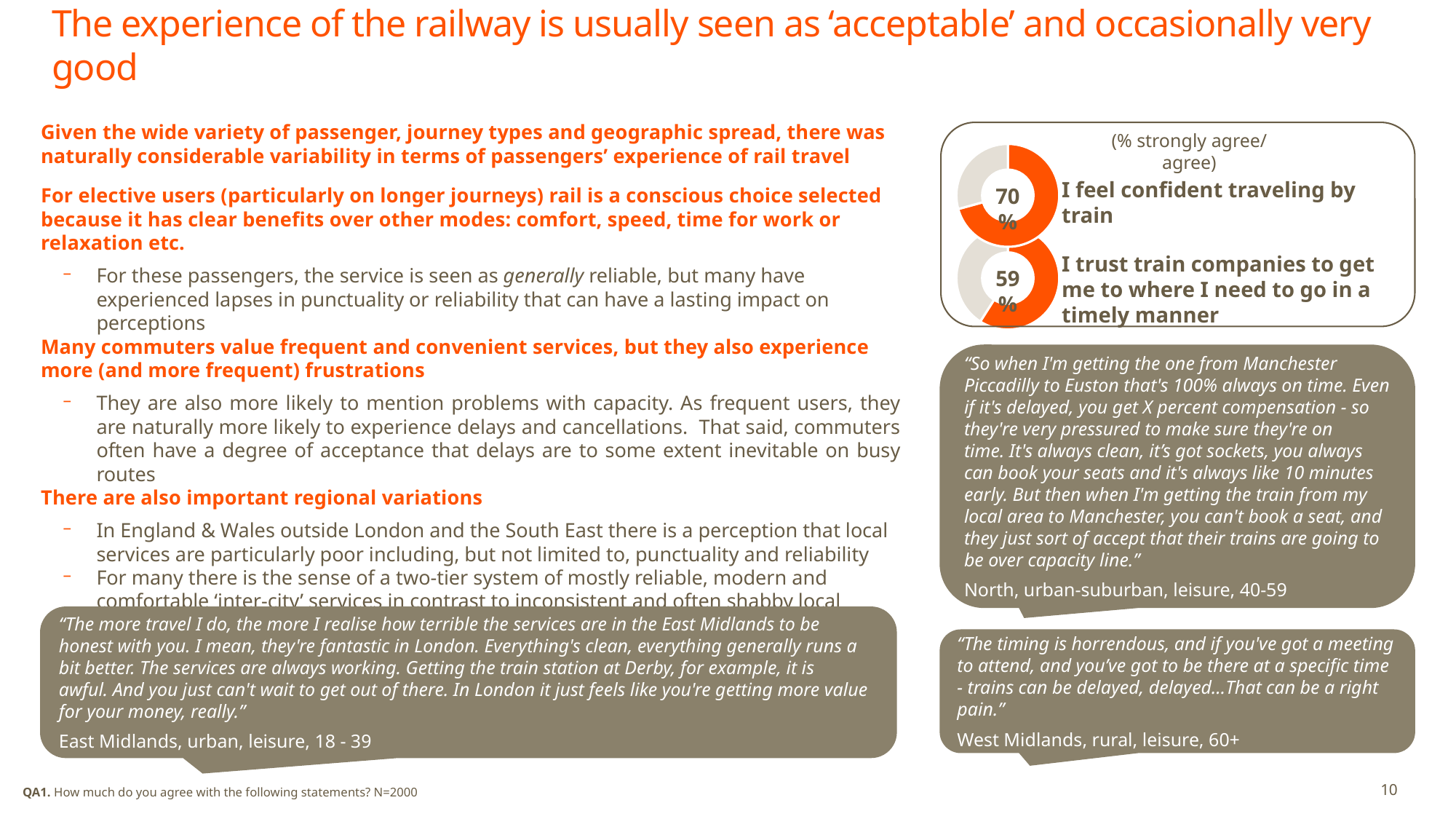
Which statement has the higher share of agreement: 'I feel confident traveling by train' or 'I trust train companies to get me to where I need to go in a timely manner'? I feel confident traveling by train Which statement has the lowest share of agreement in the donut charts? I trust train companies to get me to where I need to go in a timely manner What type of chart is used to show the agreement percentages on the right of the slide? Donut (pie) chart Is the agreement value for 'I trust train companies to get me to where I need to go in a timely manner' greater or less than 60%? less How many donut charts are shown on the slide? 2 What percentage of respondents strongly agree or agree with the statement 'I trust train companies to get me to where I need to go in a timely manner'? 59% What is the difference in percentage points between agreement with 'I feel confident traveling by train' and 'I trust train companies to get me to where I need to go in a timely manner'? 11 percentage points What percentage of respondents strongly agree or agree with the statement 'I feel confident traveling by train'? 70% Is the agreement value for 'I feel confident traveling by train' greater or less than 50%? greater What is the sample size (N) for the survey question shown in the donut charts? N=2000 What measure do the donut charts show, according to the label above them? % strongly agree/agree